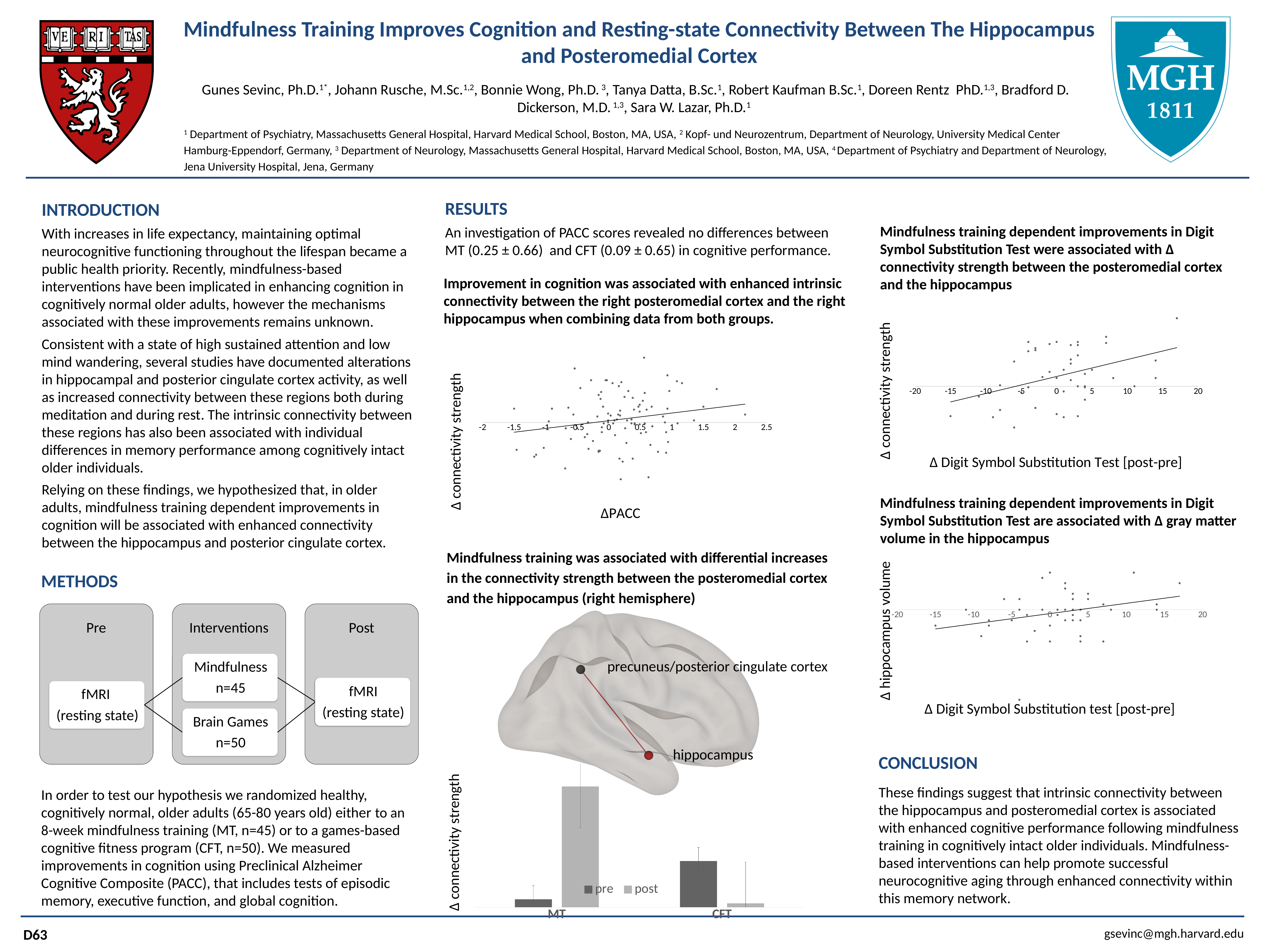
In the chart with x-axis ΔPACC, does the fitted line rise or fall as ΔPACC increases? rises In the bar chart with categories MT and CFT, which is larger for MT: pre or post? post How many categories are shown on the x axis of the bar chart with categories MT and CFT? 2 In the bar chart with categories MT and CFT, which is larger for CFT: pre or post? pre What kind of chart is the chart with y-axis Δ hippocampus volume? scatter plot What kind of chart is the chart with x-axis ΔPACC? scatter plot What is the y-axis label of the chart with x-axis ΔPACC? Δ connectivity strength How many series does the legend list in the bar chart with categories MT and CFT? 2 In the bar chart with categories MT and CFT, which bar is the tallest? MT post In the chart with y-axis Δ hippocampus volume, does the fitted line rise or fall as the x-axis value increases? rises In the chart with x-axis Δ Digit Symbol Substitution Test [post-pre] and y-axis Δ connectivity strength, does the fitted line rise or fall along the x axis? rises What kind of chart is the chart at the bottom centre with categories MT and CFT? bar chart